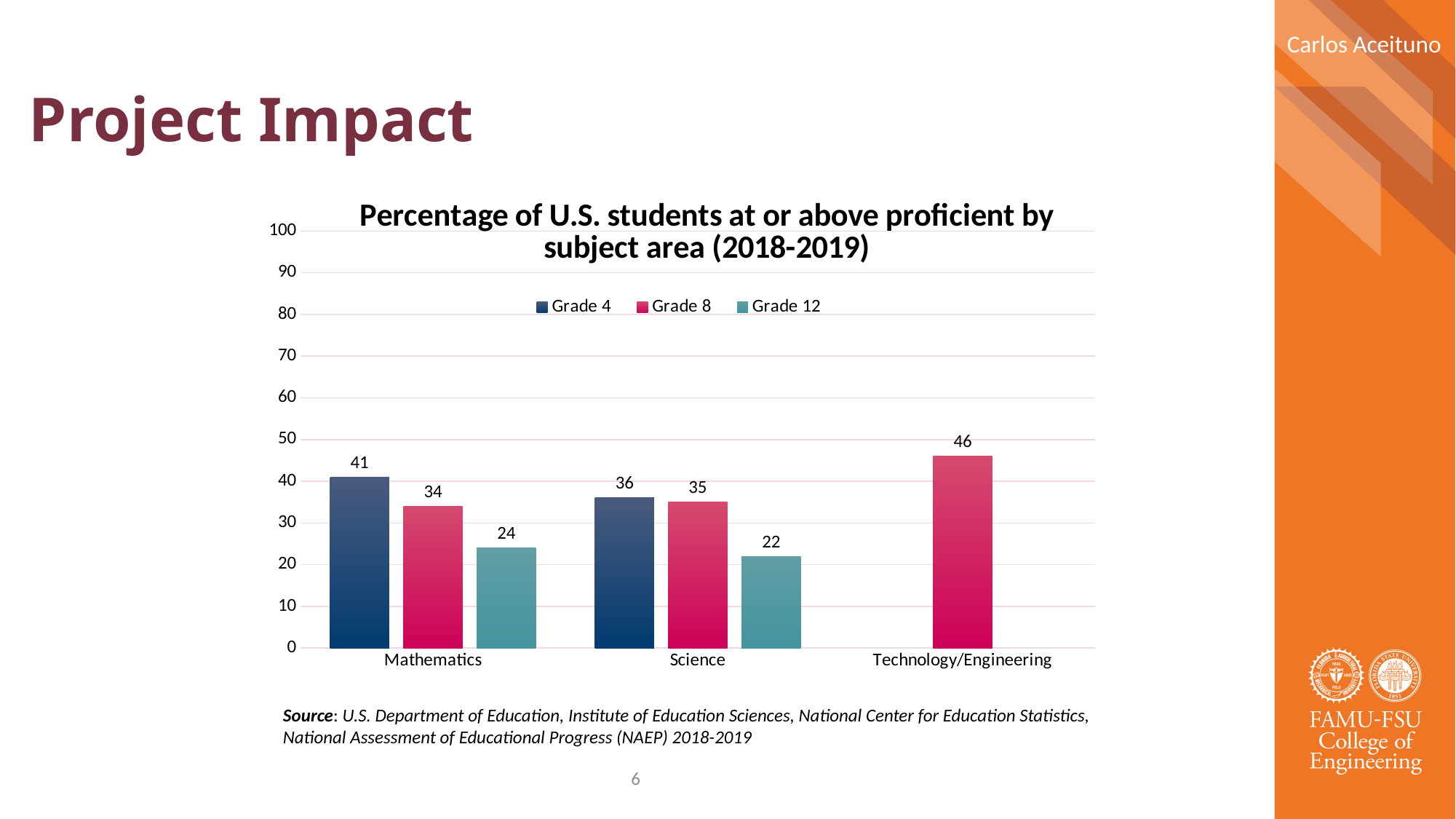
What is the difference between the Grade 4 and Grade 12 values for Mathematics? 17 Which is larger for Mathematics, the Grade 4 value or the Grade 8 value? Grade 4 Is the Grade 8 value for Technology/Engineering greater or less than 40? greater How many series does the legend list? 3 What is the Grade 4 value for Mathematics? 41 What is the title of the chart? Percentage of U.S. students at or above proficient by subject area (2018-2019) What is the Grade 8 value for Technology/Engineering? 46 Which subject area has the lowest Grade 12 value? Science What is the Grade 12 value for Science? 22 What kind of chart is shown on the slide? Bar chart How many subject areas are shown on the x axis? 3 Which subject area has the highest Grade 8 value? Technology/Engineering